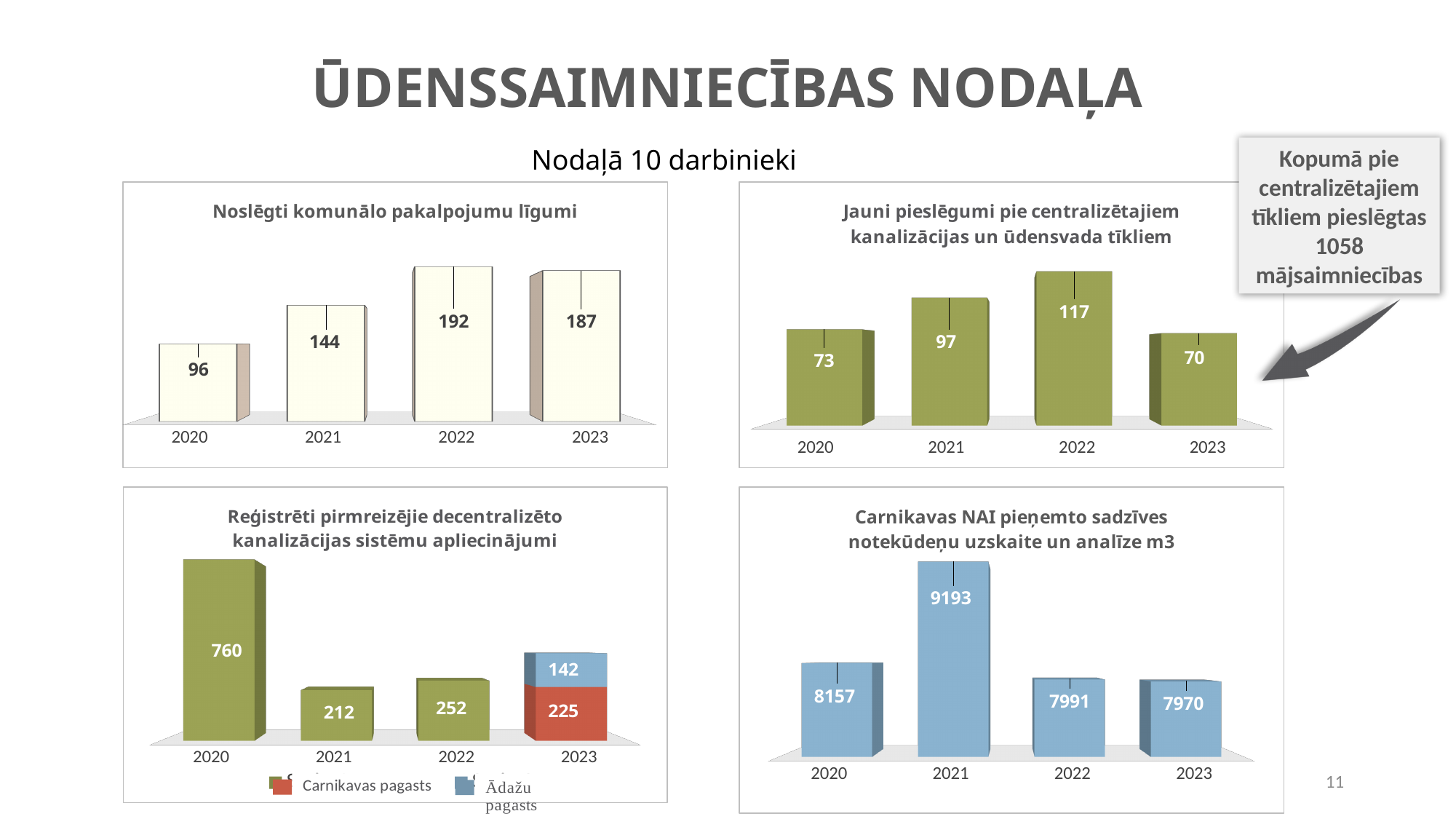
In the chart 'Noslēgti komunālo pakalpojumu līgumi', what is the difference between the values for 2021 and 2020? 48 In the chart 'Reģistrēti pirmreizējie decentralizēto kanalizācijas sistēmu apliecinājumi', what is the total of the stacked bar for 2023? 367 In the chart 'Carnikavas NAI pieņemto sadzīves notekūdeņu uzskaite un analīze m3', what is the value for 2021? 9193 In the chart 'Jauni pieslēgumi pie centralizētajiem kanalizācijas un ūdensvada tīkliem', how many years are shown on the x axis? 4 In the chart 'Reģistrēti pirmreizējie decentralizēto kanalizācijas sistēmu apliecinājumi', which is larger, the value for 2021 or 2022? 2022 In the chart 'Reģistrēti pirmreizējie decentralizēto kanalizācijas sistēmu apliecinājumi', what is the value for Ādažu pagasts in 2023? 142 What kind of chart is 'Carnikavas NAI pieņemto sadzīves notekūdeņu uzskaite un analīze m3'? Bar chart In the chart 'Noslēgti komunālo pakalpojumu līgumi', which year has the lowest value? 2020 In the chart 'Carnikavas NAI pieņemto sadzīves notekūdeņu uzskaite un analīze m3', what is the difference between the values for 2022 and 2023? 21 In the chart 'Jauni pieslēgumi pie centralizētajiem kanalizācijas un ūdensvada tīkliem', which year has the highest value? 2022 In the chart 'Jauni pieslēgumi pie centralizētajiem kanalizācijas un ūdensvada tīkliem', what is the value for 2023? 70 In the chart 'Noslēgti komunālo pakalpojumu līgumi', what is the value for 2022? 192